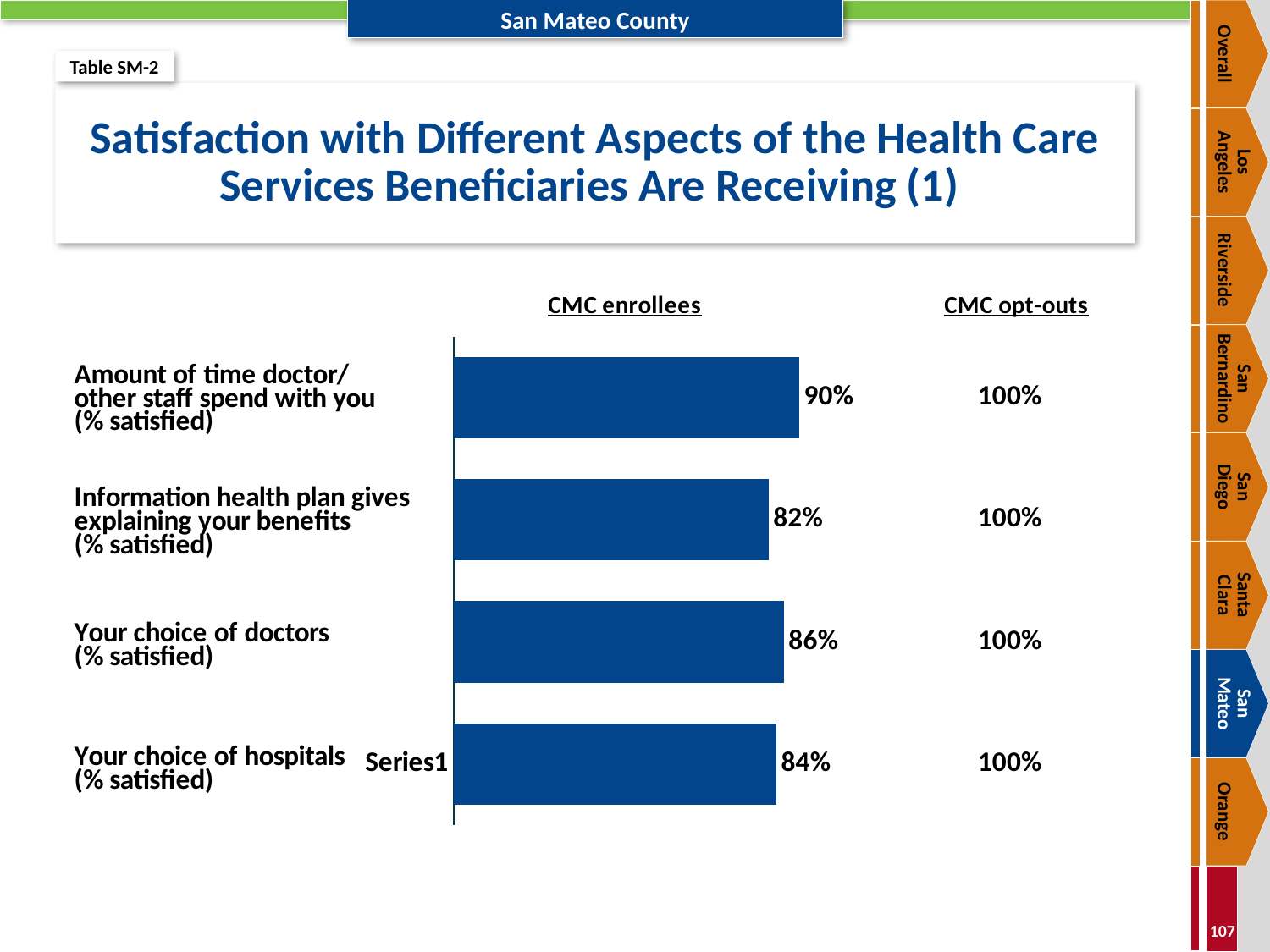
What percentage of CMC enrollees are satisfied with their choice of doctors? 86% What percentage of CMC enrollees are satisfied with the amount of time doctor/other staff spend with them? 90% Among CMC enrollees, is satisfaction higher for choice of doctors or choice of hospitals? Choice of doctors What percentage of CMC enrollees are satisfied with their choice of hospitals? 84% What type of chart is used to show CMC enrollee satisfaction? Bar chart How many aspects of health care services are shown as bars in the chart? 4 What is the difference between CMC enrollee satisfaction with the amount of time doctor/other staff spend with you and with the information the health plan gives explaining benefits? 8 percentage points What is the difference between CMC opt-out and CMC enrollee satisfaction with choice of doctors? 14 percentage points What percentage of CMC opt-outs are satisfied with their choice of hospitals? 100% Which aspect has the highest satisfaction among CMC enrollees? Amount of time doctor/other staff spend with you Which aspect has the lowest satisfaction among CMC enrollees? Information health plan gives explaining your benefits What percentage of CMC enrollees are satisfied with the information the health plan gives explaining their benefits? 82%